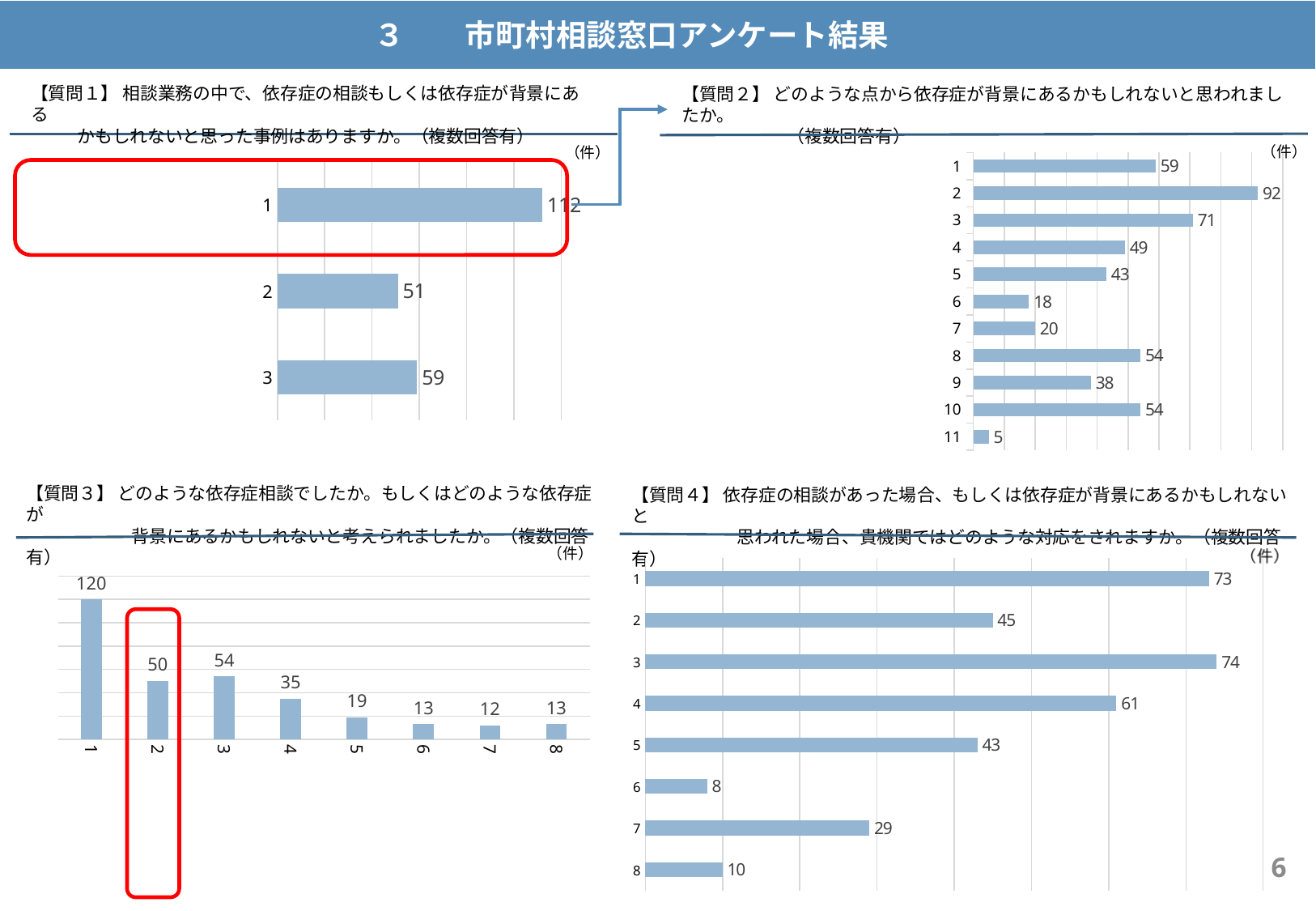
In the 質問4 chart (bottom-right), which is larger, the value for category 1 or category 4? category 1 In the 質問3 chart (bottom-left), what is the value for category 4? 35 In the 質問1 chart (top-left), what is the difference between the values for category 3 and category 2? 8 In the 質問4 chart (bottom-right), which category has the lowest value? 6 How many categories are shown in the 質問2 chart (top-right)? 11 What kind of chart is the 質問4 chart (bottom-right)? bar chart In the 質問1 chart (top-left), what is the value for category 1? 112 In the 質問2 chart (top-right), which category has the highest value? 2 In the 質問2 chart (top-right), which category has the lowest value? 11 In the 質問3 chart (bottom-left), which category has the highest value? 1 In the 質問2 chart (top-right), what is the value for category 9? 38 In the 質問3 chart (bottom-left), what is the difference between the values for category 1 and category 2? 70